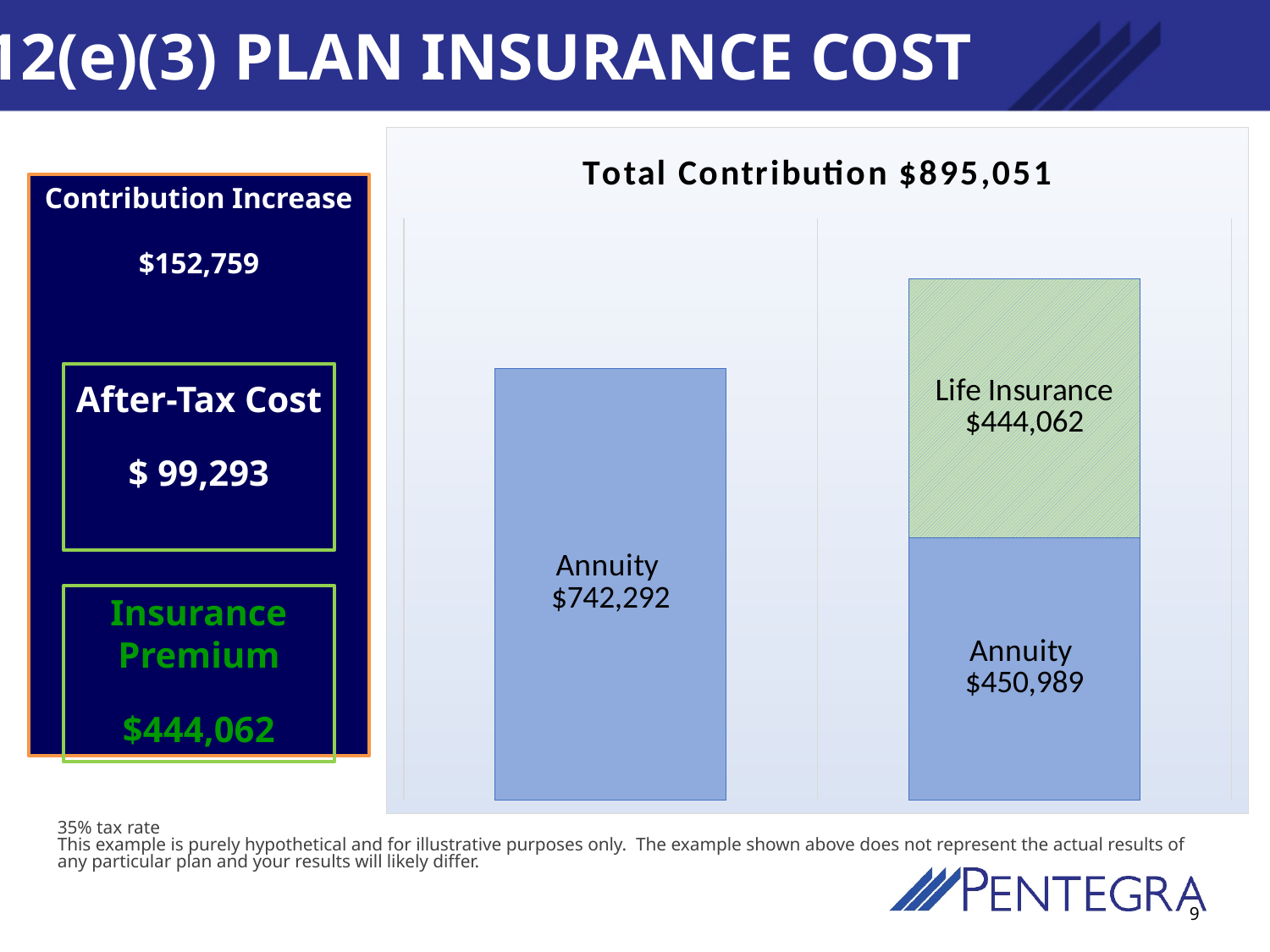
Which bar is taller overall, the left bar or the right stacked bar? The right stacked bar What is the value of the Annuity segment in the right-hand stacked bar? $450,989 What is the title of the chart? Total Contribution $895,051 What is the value of the Life Insurance segment in the right-hand stacked bar? $444,062 How many bars are plotted in the chart? 2 In the right-hand stacked bar, what is the difference between the Annuity segment and the Life Insurance segment? $6,927 What is the total of the right-hand stacked bar (Annuity plus Life Insurance)? $895,051 What type of chart is shown on the slide? Bar chart (stacked) Which is larger: the Annuity value in the left bar or the Annuity segment in the right bar? The Annuity value in the left bar ($742,292) Which segment of the chart is shown with a green hatched fill? Life Insurance What is the difference between the Annuity value in the left bar and the Annuity segment in the right bar? $291,303 What is the value of the Annuity bar on the left of the chart? $742,292